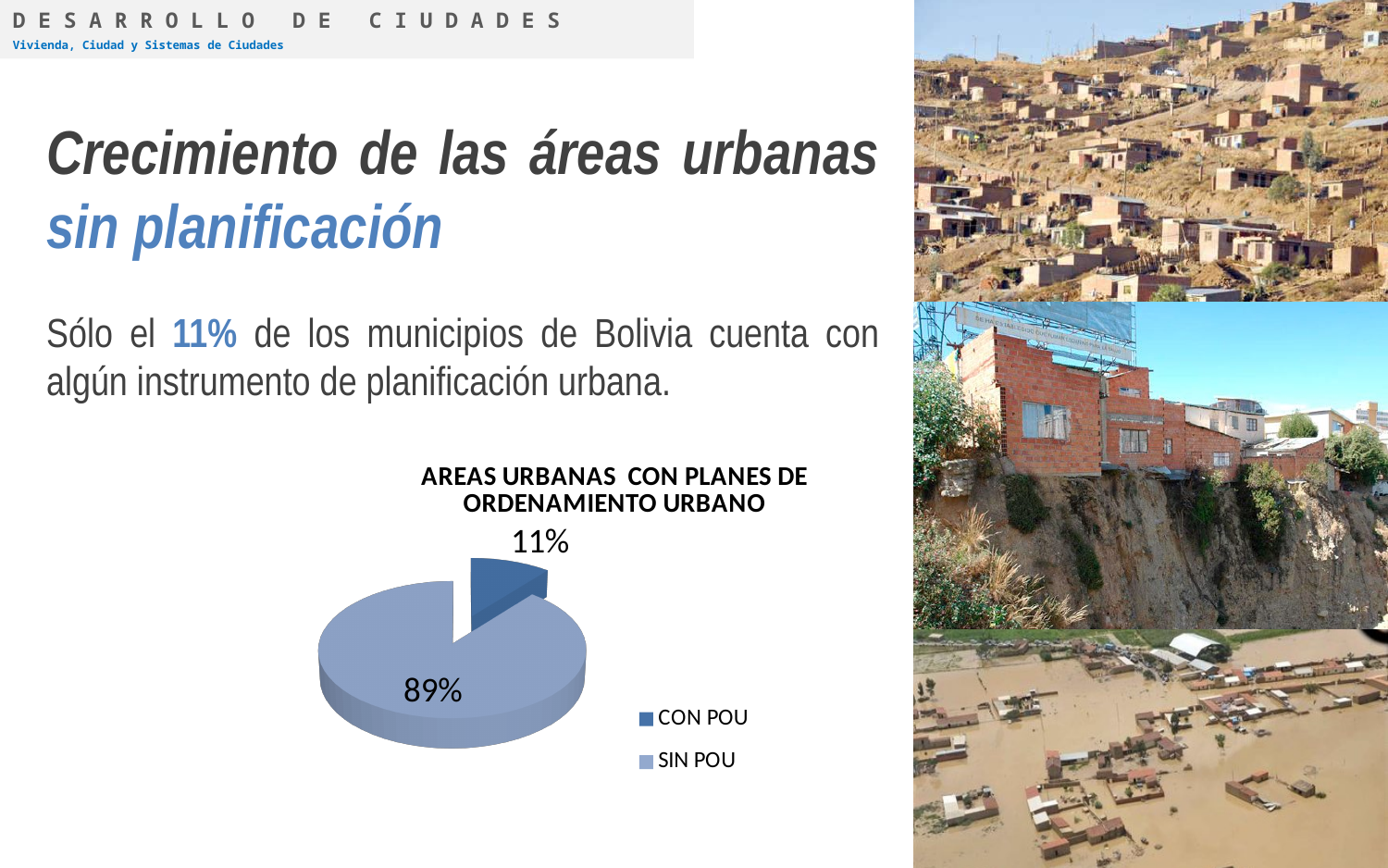
What type of chart is shown on the slide? Pie chart What percentage of the pie is labelled CON POU? 11% Which legend entry is shown in the darker blue colour? CON POU How many entries does the legend list? 2 What percentage of the pie is labelled SIN POU? 89% Which slice of the pie is the largest? SIN POU Which slice of the pie is the smallest? CON POU Which is larger, the CON POU slice or the SIN POU slice? SIN POU What is the difference in percentage points between the SIN POU and CON POU slices? 78 What share of the pie does the CON POU slice represent? 11% How many slices does the pie chart have? 2 What is the title of the chart? AREAS URBANAS CON PLANES DE ORDENAMIENTO URBANO